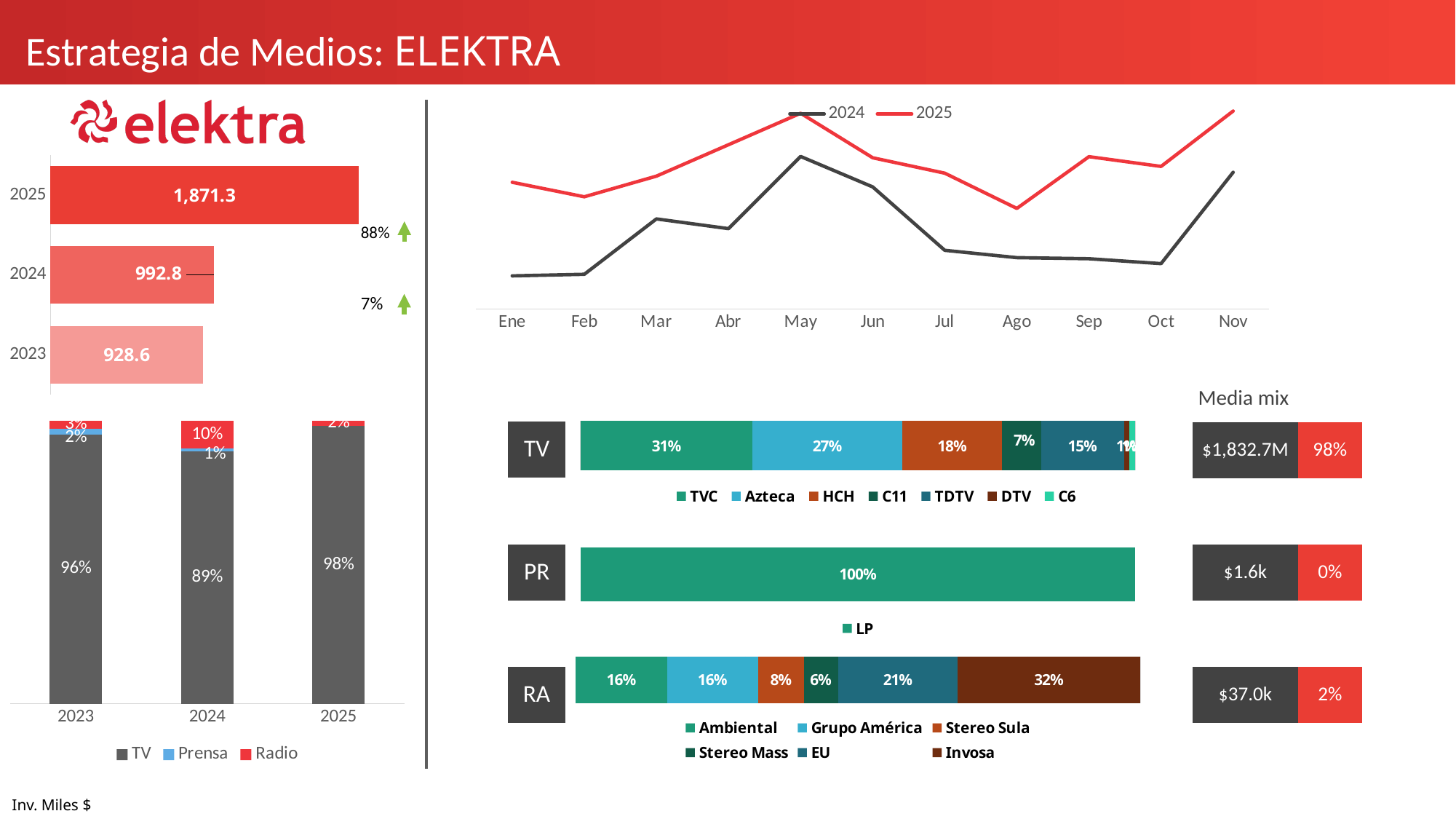
In the horizontal bar chart of yearly investment on the left, what is the difference between the 2025 and 2024 values? 878.5 In the horizontal bar chart of yearly investment on the left, what is the value for 2025? 1,871.3 In the horizontal bar chart of yearly investment on the left, what percentage growth is shown between 2024 and 2025? 88% In the line chart of monthly investment at the top right, how many series does the legend list? 2 In the stacked bar chart of media share by year at the bottom left, what is the Radio share for 2024? 10% In the stacked bar chart of media share by year at the bottom left, what is the TV share for 2024? 89% In the TV stacked bar on the right, what is the share for Azteca? 27% In the horizontal bar chart of yearly investment on the left, what is the value for 2023? 928.6 In the RA stacked bar on the right, which station has the largest share? Invosa In the line chart of monthly investment at the top right, which series is higher in Ago, 2024 or 2025? 2025 In the line chart of monthly investment at the top right, in which month does the 2024 line reach its highest point? May In the horizontal bar chart of yearly investment on the left, which year has the highest value? 2025